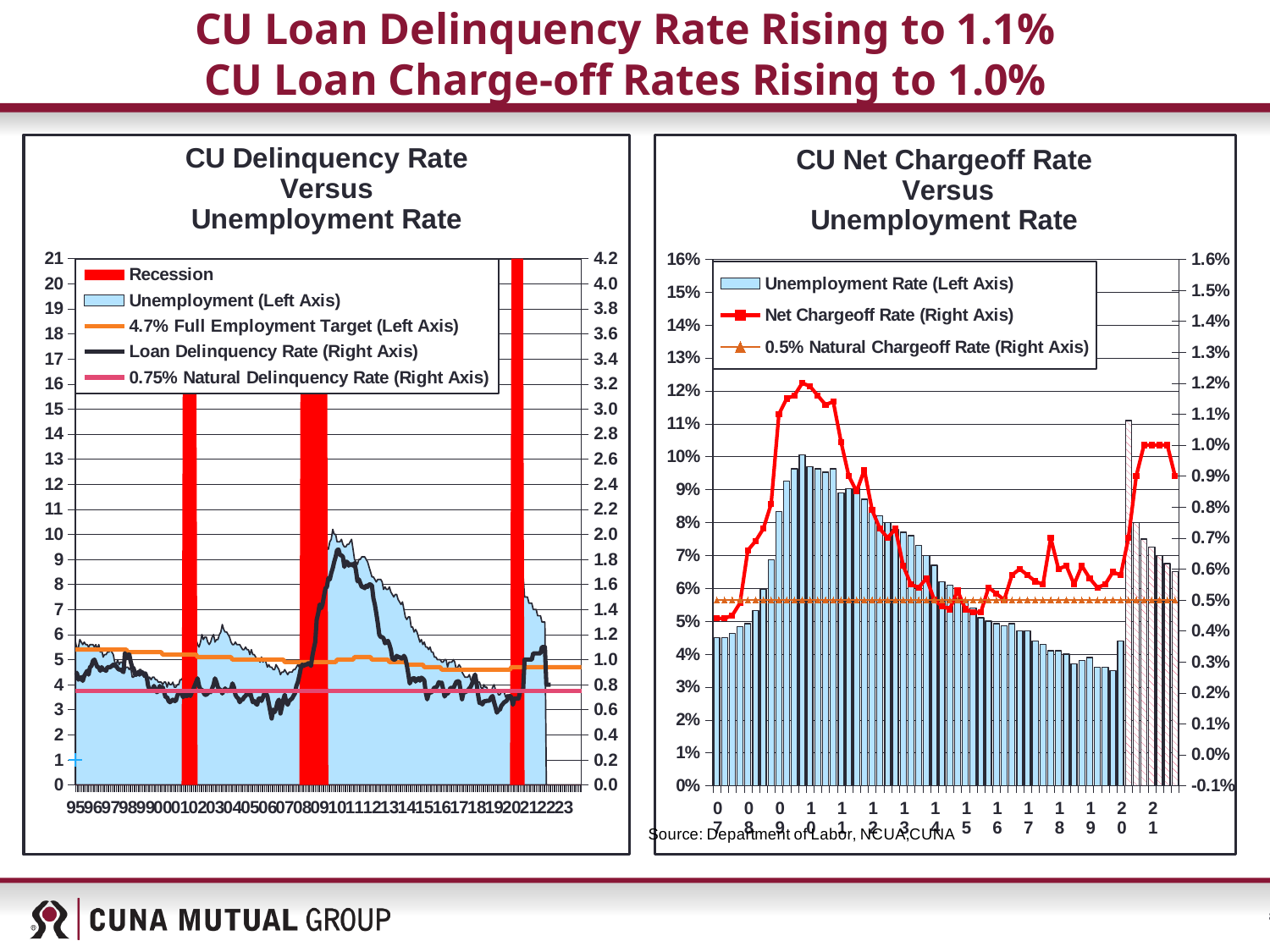
On the right chart, what is the value of the Natural Chargeoff Rate line according to the legend? 0.5% On the right chart, is the Unemployment Rate in 2019 greater or less than 5%? less On the left chart, which axis is the Loan Delinquency Rate plotted against, according to the legend? Right Axis On the left chart, how many recession bars are shaded in red? 3 On the 'CU Delinquency Rate Versus Unemployment Rate' chart, how many series does the legend list? 5 On the 'CU Net Chargeoff Rate Versus Unemployment Rate' chart, how many series does the legend list? 3 On the left chart, what is the value of the Full Employment Target line according to the legend? 4.7% On the right chart, what kind of chart is used to plot the Unemployment Rate series? bar chart On the left chart, is the peak unemployment value around 2010 greater or less than 8? greater On the left chart, what is the value of the Natural Delinquency Rate line according to the legend? 0.75%